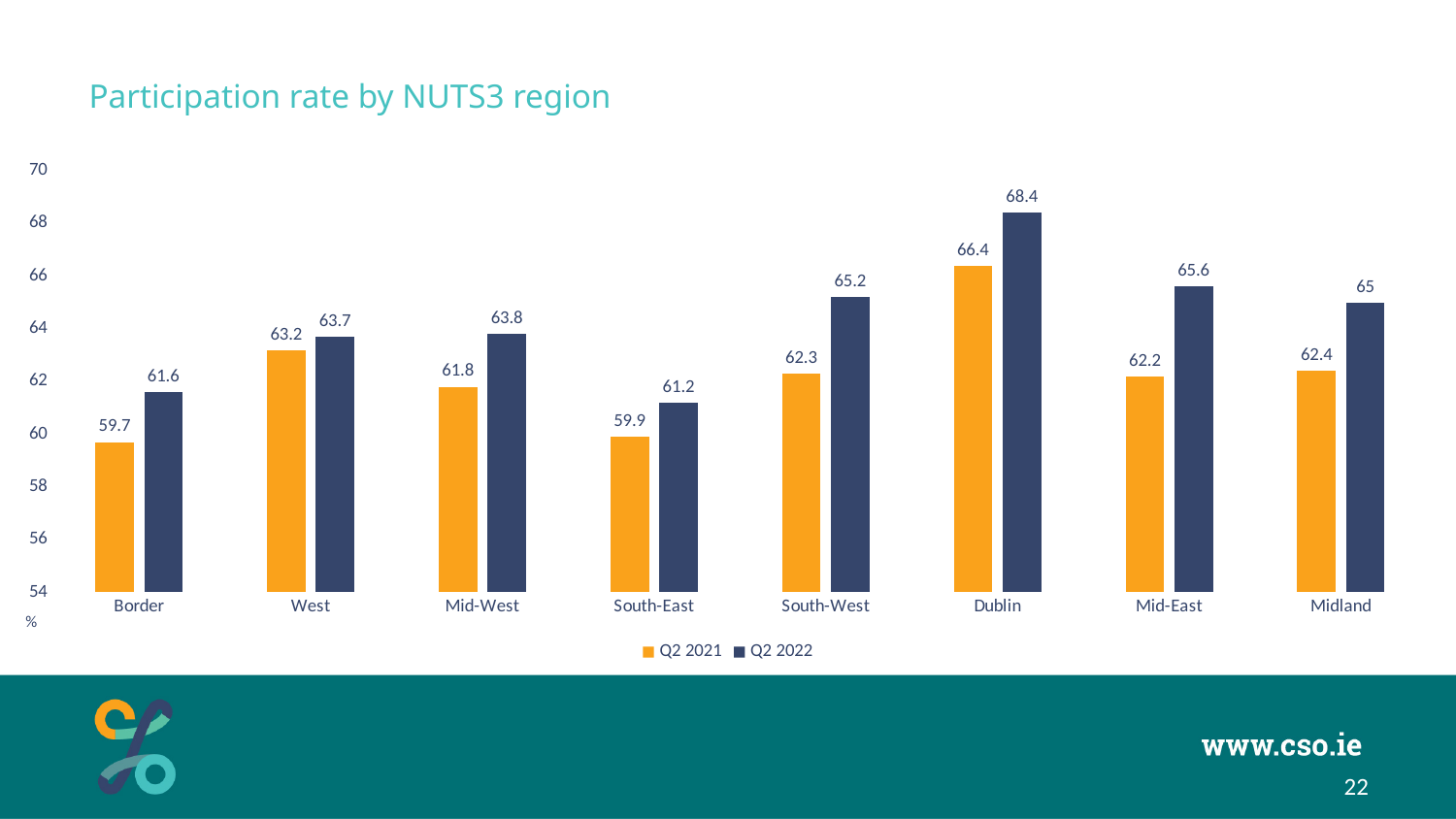
What is the title of the chart? Participation rate by NUTS3 region What is the difference between the Q2 2022 and Q2 2021 participation rates for South-West? 2.9 What is the participation rate for Border in Q2 2021? 59.7 Which region has the highest participation rate in Q2 2022? Dublin What kind of chart is shown on the slide? Bar chart What is the participation rate for Mid-East in Q2 2022? 65.6 How many regions are shown on the chart? 8 What is the participation rate for Dublin in Q2 2022? 68.4 Which region has the lowest participation rate in Q2 2021? Border How many series does the legend list? 2 Is the Q2 2022 participation rate for South-East greater or less than 62? less Which is larger, the Q2 2021 participation rate for West or for Midland? West